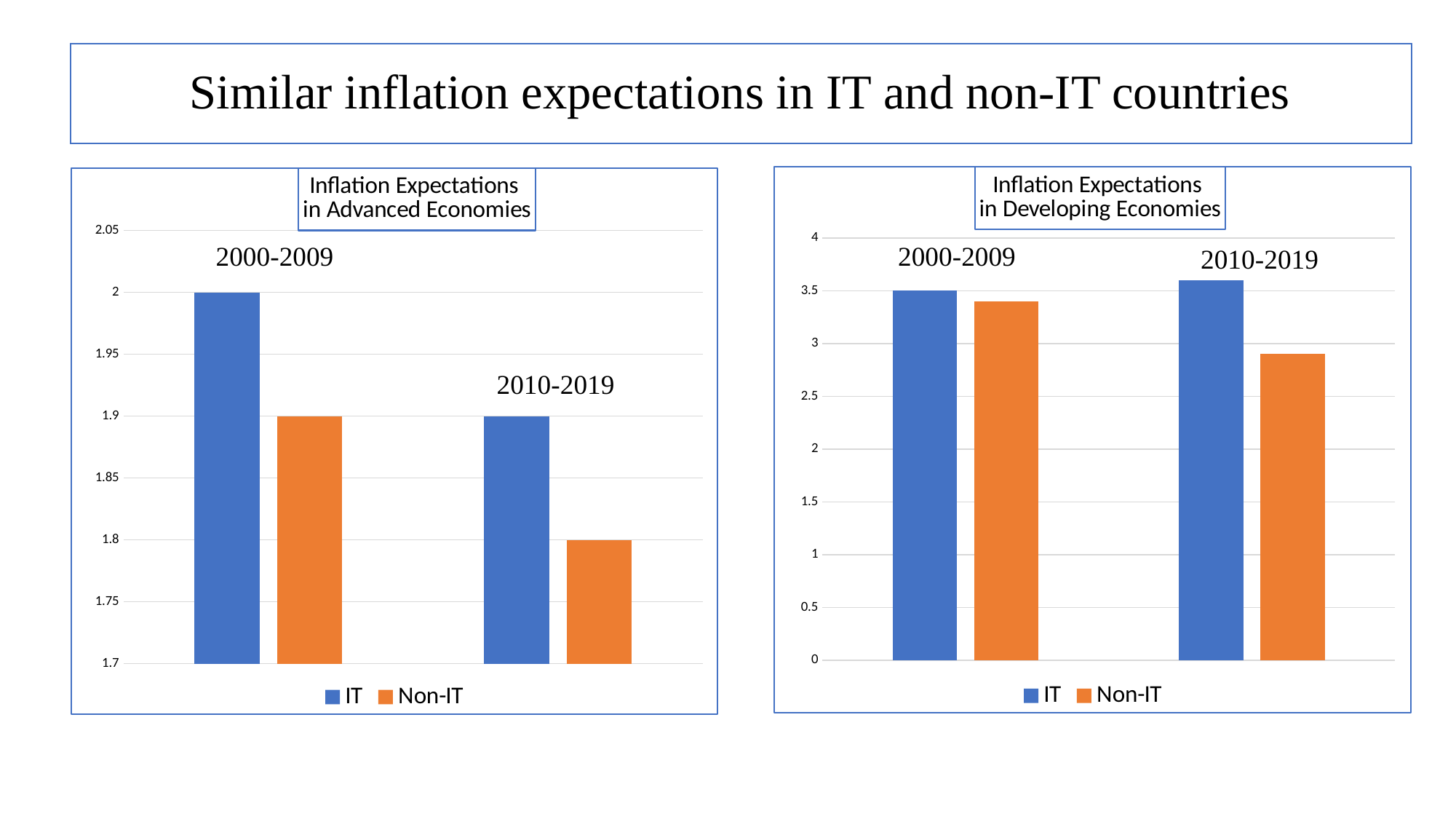
In the Inflation Expectations in Developing Economies chart, is the value for IT in 2010-2019 greater or less than 3.5? greater In the Inflation Expectations in Developing Economies chart, what is the value for IT in 2000-2009? 3.5 In the Inflation Expectations in Advanced Economies chart, what is the difference between IT and Non-IT in 2000-2009? 0.1 In the Inflation Expectations in Developing Economies chart, does the Non-IT value rise or fall from 2000-2009 to 2010-2019? fall In the Inflation Expectations in Developing Economies chart, which is larger in 2010-2019, IT or Non-IT? IT In the Inflation Expectations in Developing Economies chart, is the value for Non-IT in 2010-2019 greater or less than 3? less In the Inflation Expectations in Advanced Economies chart, what is the value for Non-IT in 2000-2009? 1.9 What kind of chart is the Inflation Expectations in Developing Economies chart? bar chart How many series does the legend of the Inflation Expectations in Advanced Economies chart list? 2 In the Inflation Expectations in Advanced Economies chart, what is the value for Non-IT in 2010-2019? 1.8 In the Inflation Expectations in Advanced Economies chart, which series has the lowest bar? Non-IT in 2010-2019 In the Inflation Expectations in Advanced Economies chart, what is the value for IT in 2000-2009? 2